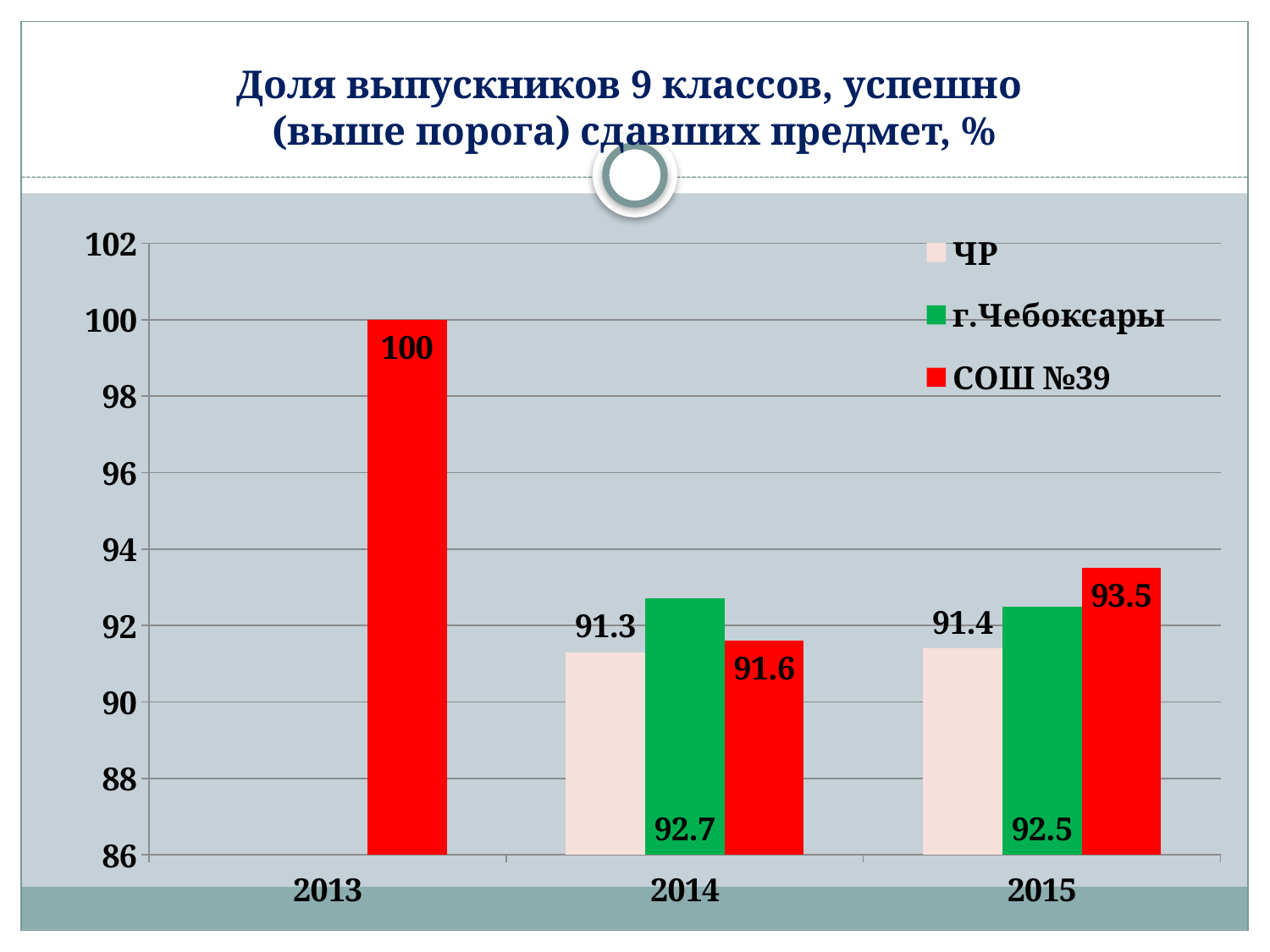
What is the value for СОШ №39 in 2015? 93.5 Which is larger in 2014: the value for г.Чебоксары or the value for СОШ №39? г.Чебоксары What is the value for ЧР in 2015? 91.4 What is the difference between the СОШ №39 value in 2015 and the СОШ №39 value in 2014? 1.9 What is the value for СОШ №39 in 2013? 100 In which year is the value for СОШ №39 highest? 2013 How many series does the legend list? 3 What is the value for г.Чебоксары in 2014? 92.7 Is the value for СОШ №39 in 2014 greater or less than 92? less What kind of chart is shown on the slide? bar chart How many years are shown on the x axis? 3 Which series has the lowest value in 2014? ЧР